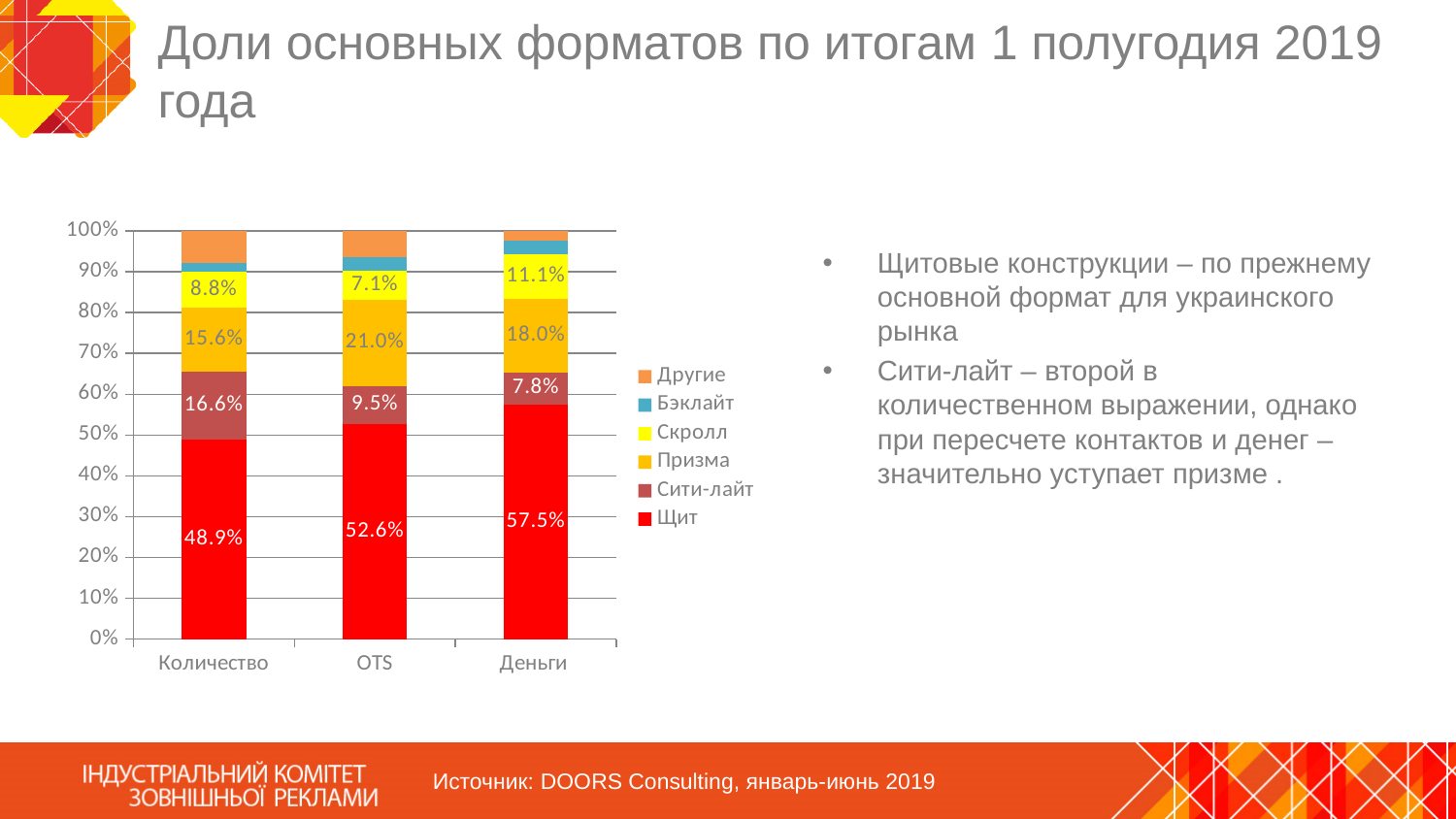
What is the difference between the Щит values for Деньги and Количество? 8.6% For which category is the Щит share highest? Деньги What kind of chart is shown on the slide? Stacked bar chart How many categories are shown on the x axis? 3 For which category is the Сити-лайт share lowest? Деньги What is the value of Призма for OTS? 21.0% What is the value of Щит for Деньги? 57.5% What is the value of Сити-лайт for OTS? 9.5% What is the value of Щит for Количество? 48.9% How many series does the legend list? 6 Which is larger for Количество: Сити-лайт or Призма? Сити-лайт What is the value of Скролл for Деньги? 11.1%